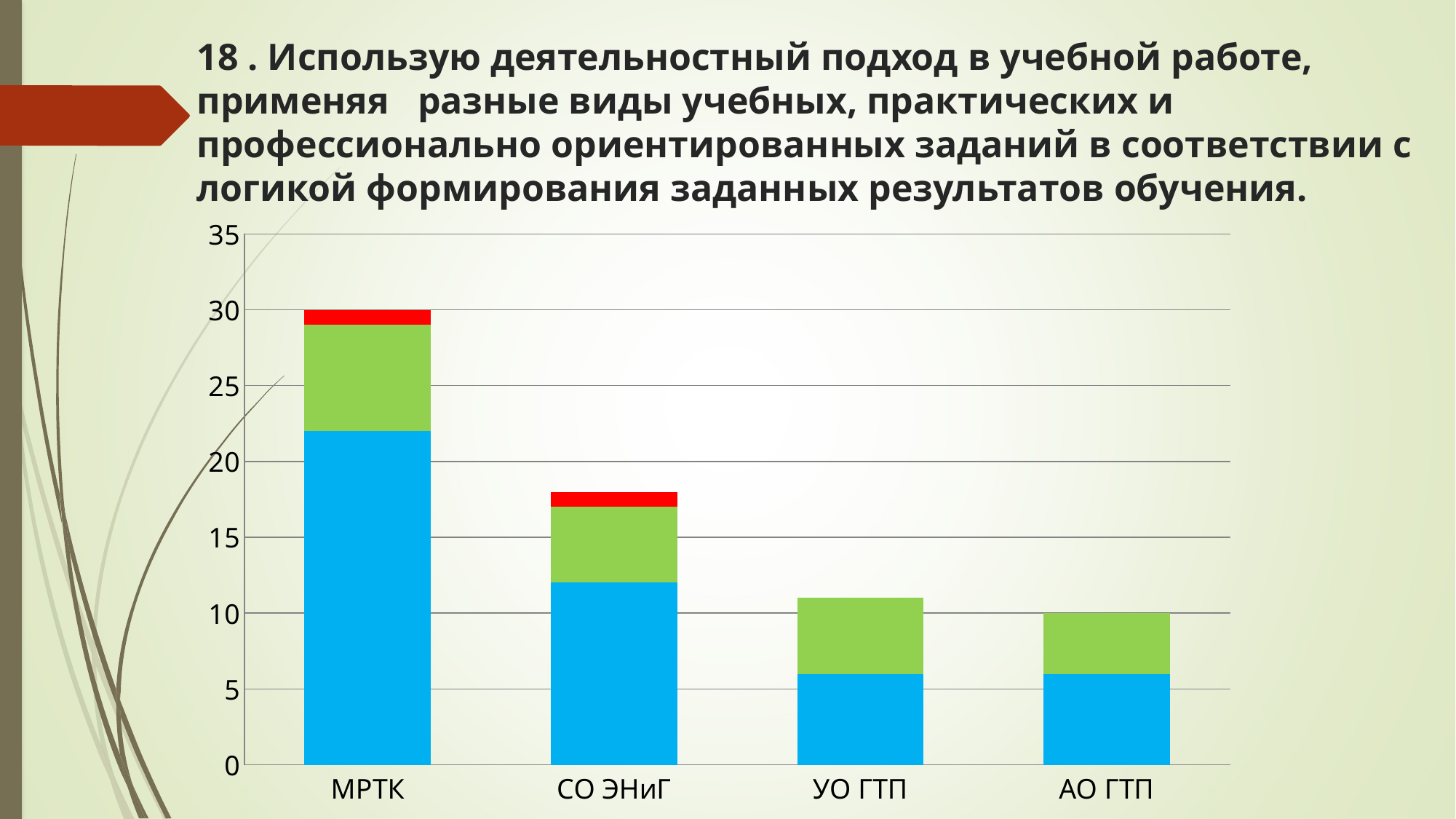
How many categories are shown on the x axis of the chart? 4 Is the blue segment for МРТК greater or less than 20? greater What is the total height of the stacked bar for МРТК? 30 Which stacked bar is taller, СО ЭНиГ or УО ГТП? СО ЭНиГ Is the total for УО ГТП greater or less than 15? less Which category has the tallest stacked bar? МРТК What kind of chart is shown on the slide? stacked bar chart Which two categories have no red segment in their bars? УО ГТП and АО ГТП What is the total height of the stacked bar for АО ГТП? 10 Do the bar totals rise or fall from left to right across the x axis? fall Which category has the shortest stacked bar? АО ГТП Is the total for СО ЭНиГ greater or less than 15? greater